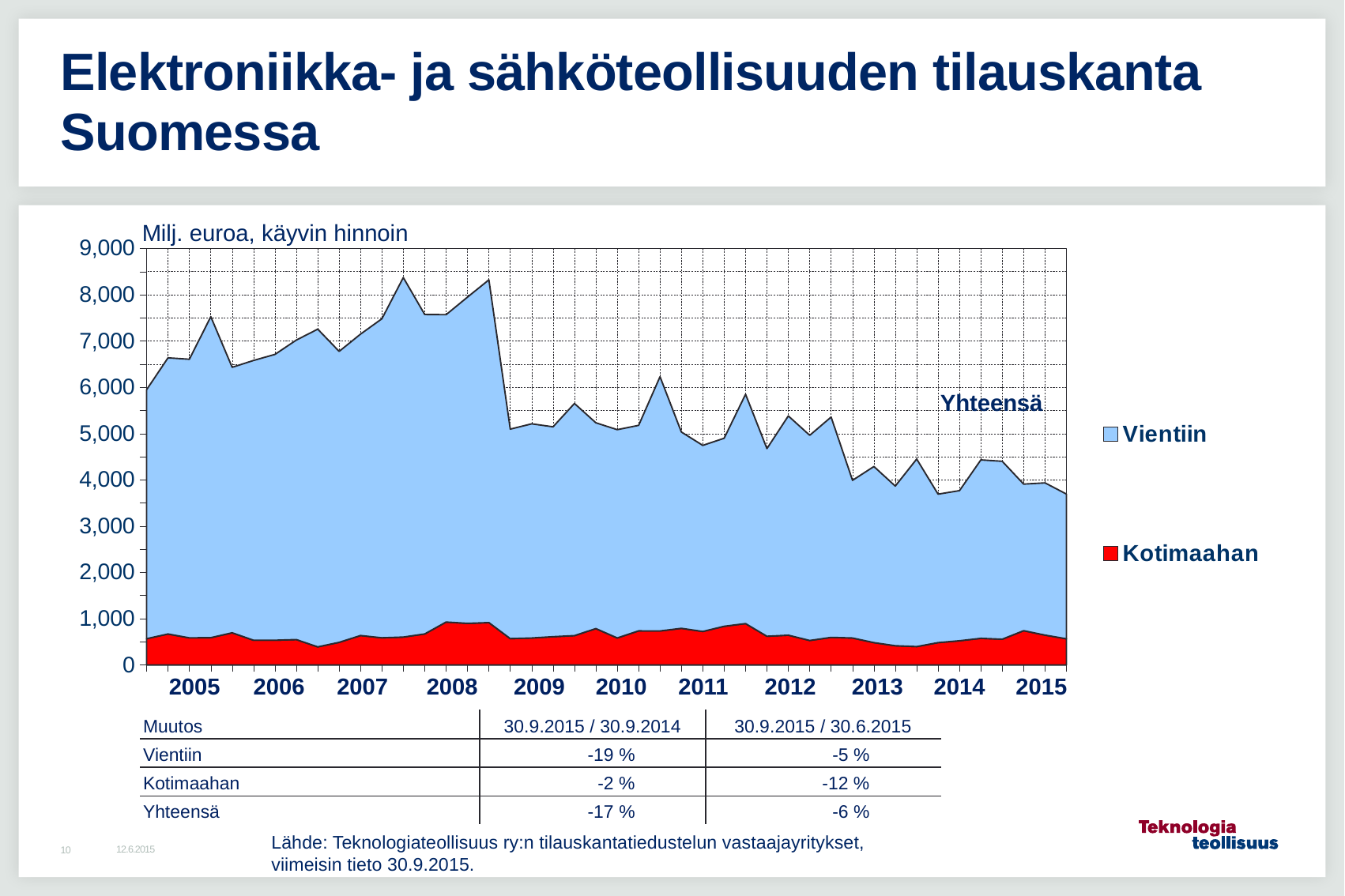
What are the two series named in the chart's legend? Vientiin and Kotimaahan What kind of chart is shown on the slide? Area chart In which year does the total (Yhteensä) reach its highest point? 2007 Does the total order backlog generally rise or fall from 2008 to 2015? Fall What unit label is shown above the chart's vertical axis? Milj. euroa, käyvin hinnoin Which is larger, the total order backlog in 2007 or in 2014? 2007 Is the total (Yhteensä) value in 2012 greater or less than 4,000? greater Is the total (Yhteensä) value at the end of 2015 greater or less than 4,000? less Is the Kotimaahan value in 2013 greater or less than 1,000? less How many series does the chart's legend list? 2 How many years are labelled on the chart's x axis? 11